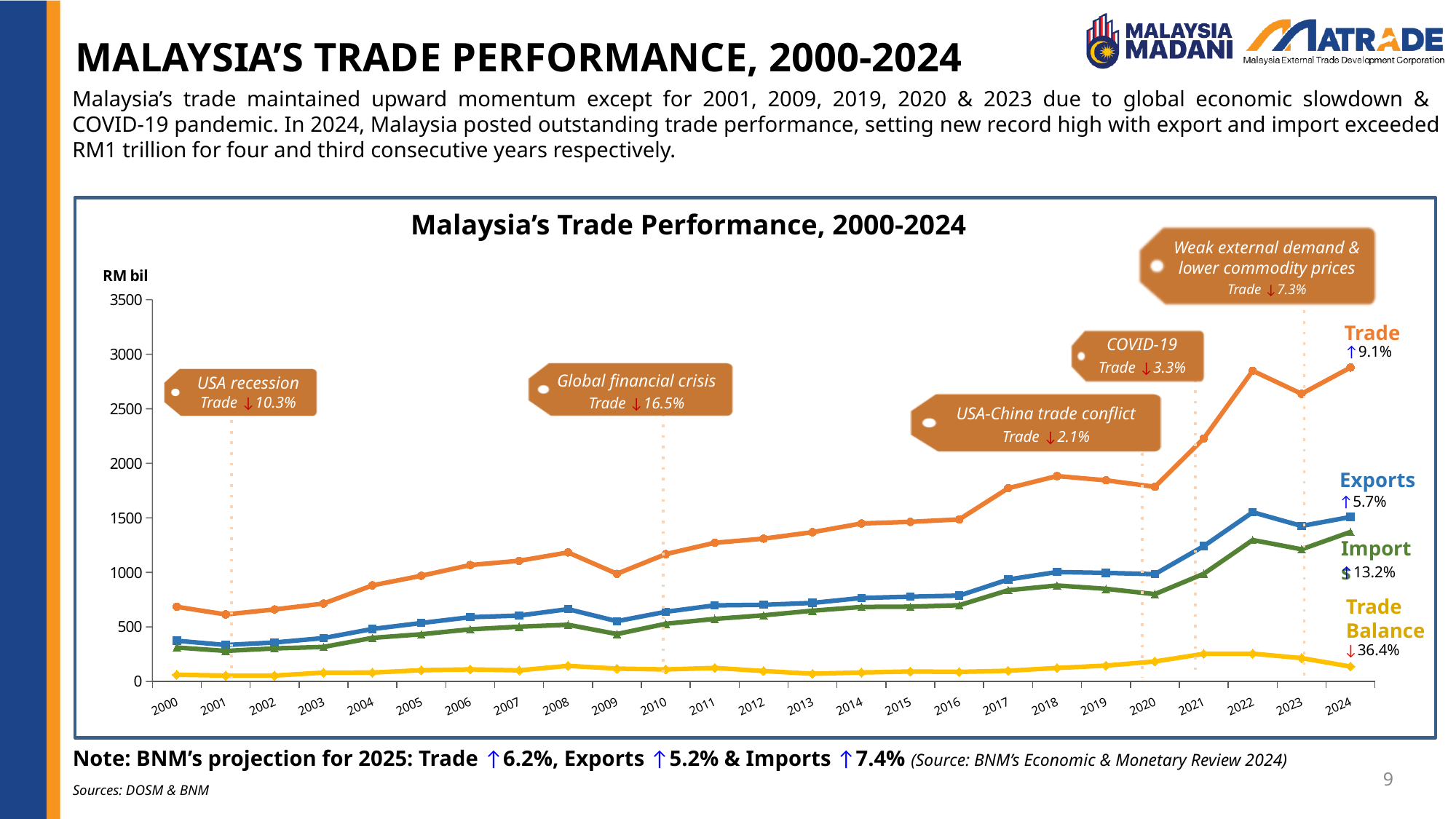
Is the value for Trade in 2000 greater or less than 1000? less Is the value for Import in 2009 greater or less than 500? less In which year is the Trade line at its lowest? 2001 What is the unit shown on the y axis of the chart? RM bil How many years are shown along the x axis of the chart? 25 What growth percentage is labelled for Trade in 2024? ↑9.1% Which year has the higher Trade value, 2022 or 2023? 2022 Which is higher in 2024, Exports or Import? Exports In which year is the Trade line at its highest? 2024 Is the value for Trade in 2024 greater or less than 2500? greater What kind of chart is shown on the slide? Line chart How many series are plotted on the chart? 4